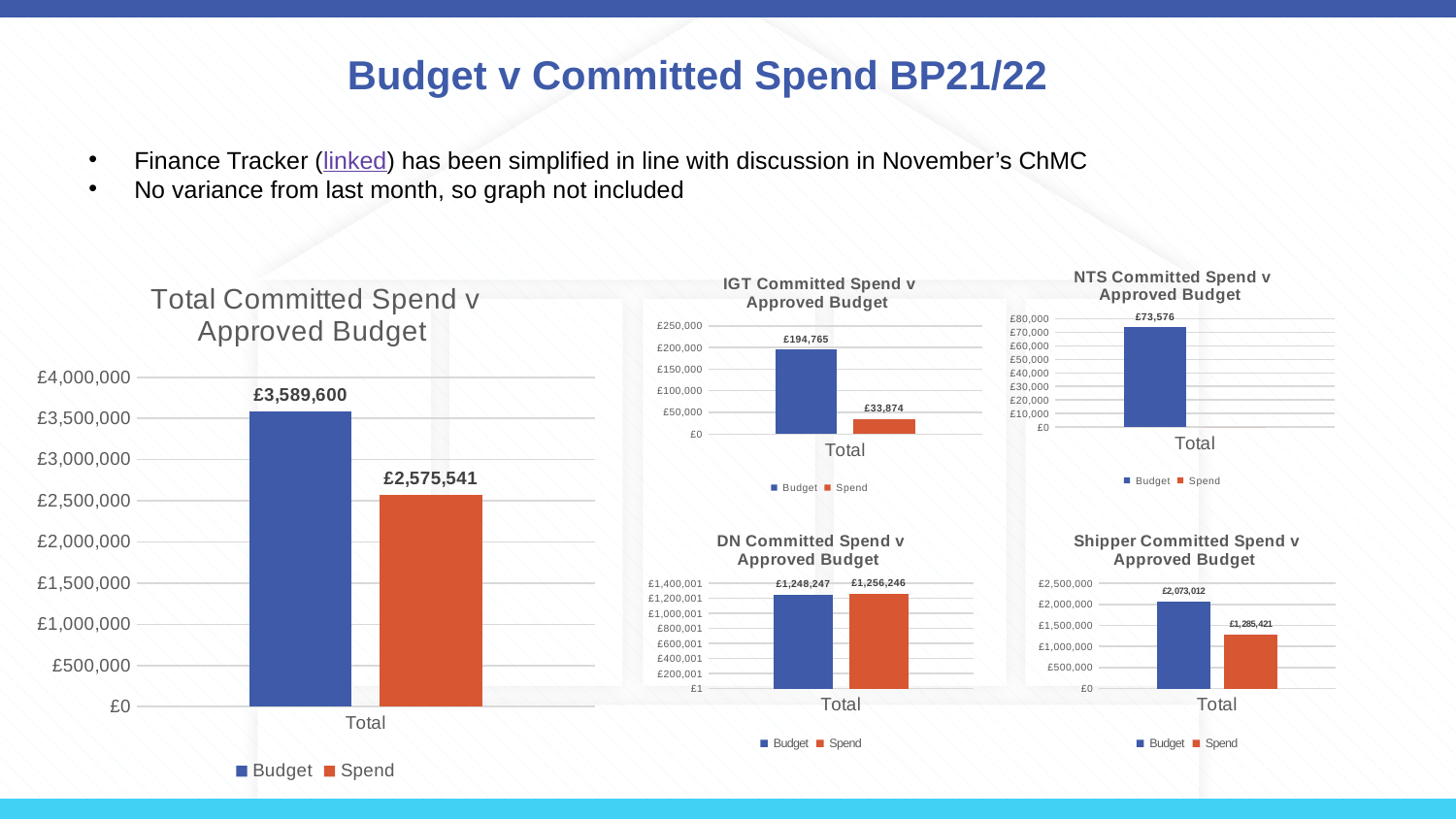
In the Shipper Committed Spend v Approved Budget chart, what is the value for Spend? £1,285,421 In the DN Committed Spend v Approved Budget chart, which is larger, Budget or Spend? Spend In the IGT Committed Spend v Approved Budget chart, what is the difference between Budget and Spend? £160,891 In the NTS Committed Spend v Approved Budget chart, what is the value for Budget? £73,576 In the Total Committed Spend v Approved Budget chart, what is the difference between Budget and Spend? £1,014,059 In the IGT Committed Spend v Approved Budget chart, what is the value for Spend? £33,874 In the DN Committed Spend v Approved Budget chart, what is the value for Budget? £1,248,247 In the Total Committed Spend v Approved Budget chart, what is the value for Budget? £3,589,600 How many series does the legend list in the Total Committed Spend v Approved Budget chart? 2 In the Shipper Committed Spend v Approved Budget chart, is the value for Budget greater or less than £2,000,000? greater What kind of chart is the Shipper Committed Spend v Approved Budget chart? bar chart In the Total Committed Spend v Approved Budget chart, what is the value for Spend? £2,575,541